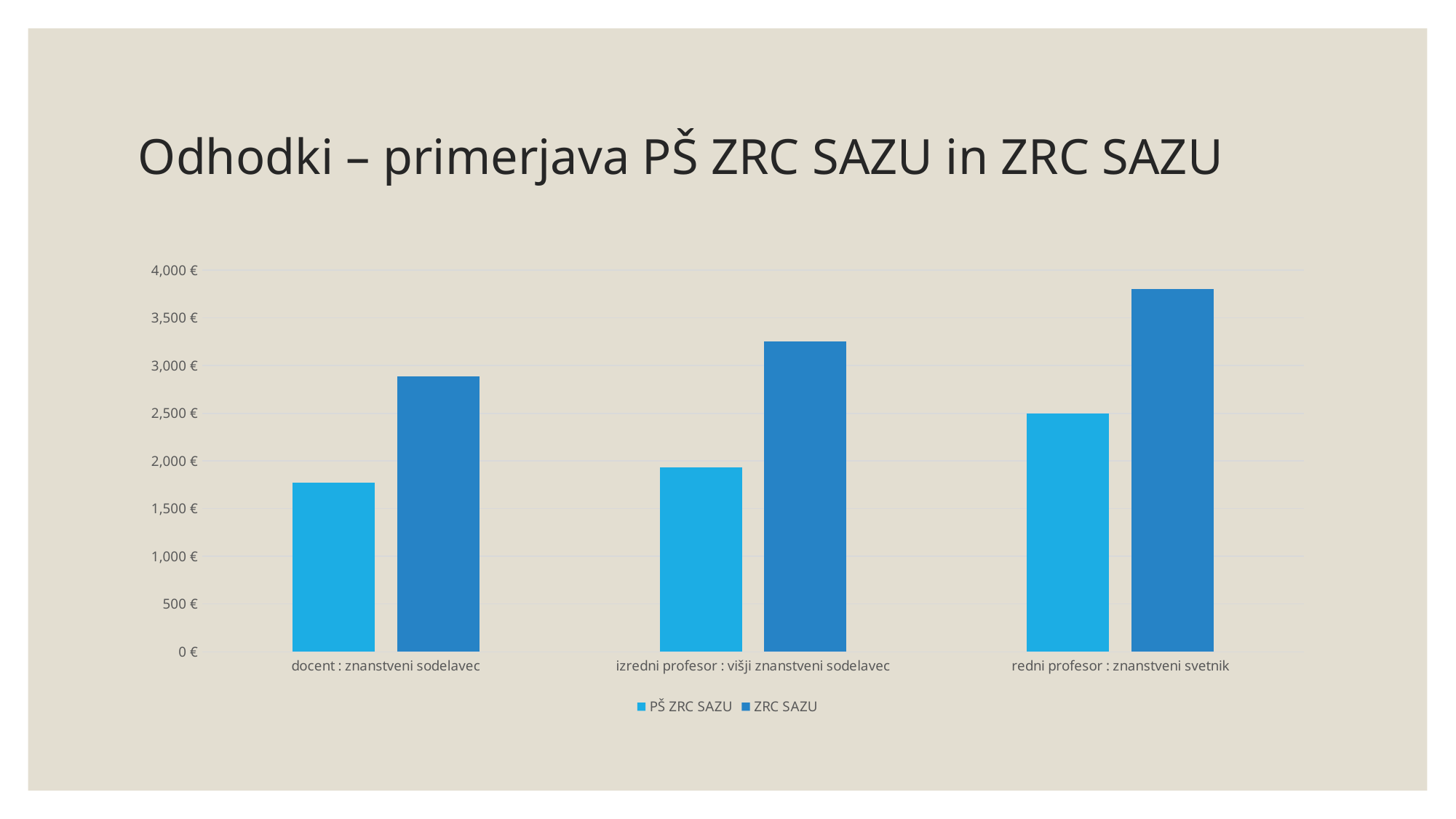
How many categories are shown on the x axis? 3 Do the ZRC SAZU values rise or fall from left to right along the x axis? rise What is the title of the slide? Odhodki – primerjava PŠ ZRC SAZU in ZRC SAZU Which series is shown in the darker blue colour? ZRC SAZU Which category has the lowest PŠ ZRC SAZU value? docent : znanstveni sodelavec What kind of chart is shown on the slide? bar chart For izredni profesor : višji znanstveni sodelavec, which series has the larger value, PŠ ZRC SAZU or ZRC SAZU? ZRC SAZU How many series does the legend list? 2 Is the PŠ ZRC SAZU value for izredni profesor : višji znanstveni sodelavec greater or less than 2,000 €? less Is the ZRC SAZU value for docent : znanstveni sodelavec greater or less than 2,500 €? greater Which category has the highest ZRC SAZU value? redni profesor : znanstveni svetnik Is the ZRC SAZU value for redni profesor : znanstveni svetnik greater or less than 3,500 €? greater